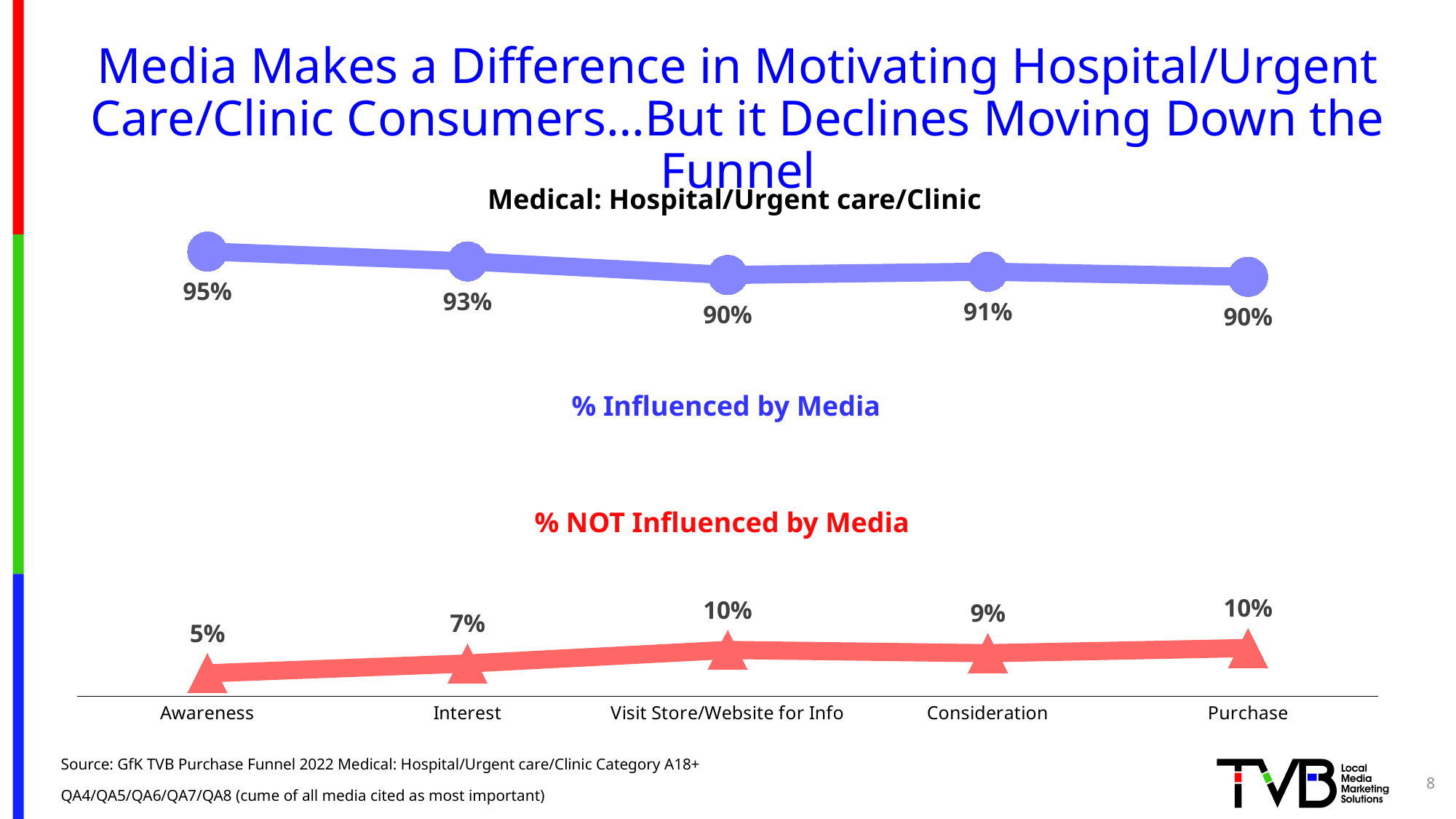
Which is larger: % NOT Influenced by Media at Interest or at Consideration? Consideration What is the difference between % Influenced by Media at Awareness and at Purchase? 5% What kind of chart is shown on the slide? Line chart What is the title of the chart? Medical: Hospital/Urgent care/Clinic Which stage has the lowest value for % NOT Influenced by Media? Awareness What is the value of % NOT Influenced by Media at the Purchase stage? 10% What is the value of % Influenced by Media at the Consideration stage? 91% What is the value of % Influenced by Media at the Awareness stage? 95% How many funnel stages are shown on the x axis? 5 Does % Influenced by Media generally rise or fall moving from Awareness to Purchase? Fall How many data series are plotted on the chart? 2 Which stage has the highest value for % Influenced by Media? Awareness